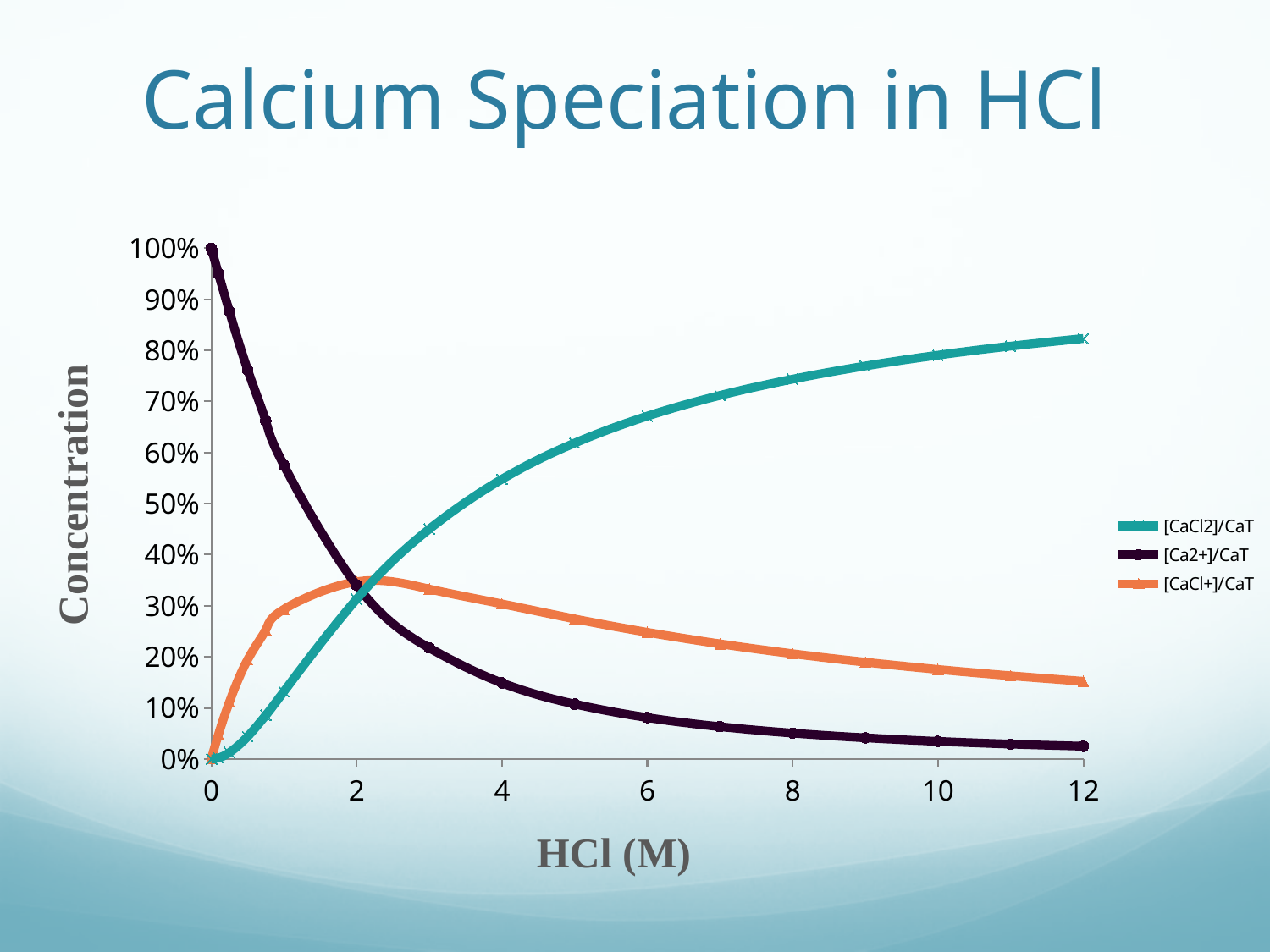
At 8 M HCl, which is larger, [CaCl+]/CaT or [Ca2+]/CaT? [CaCl+]/CaT What is the value of [CaCl2]/CaT at 0 M HCl? 0% Does the [Ca2+]/CaT series rise or fall as HCl concentration increases? fall Is the value for [Ca2+]/CaT at 12 M HCl greater or less than 10%? less Is the value for [CaCl2]/CaT at 12 M HCl greater or less than 80%? greater What kind of chart is shown on the slide? line chart How many series does the legend list? 3 What is the label of the x axis? HCl (M) Does the [CaCl2]/CaT series rise or fall as HCl concentration increases? rise What is the title of the chart? Calcium Speciation in HCl Which series has the highest value at 12 M HCl? [CaCl2]/CaT